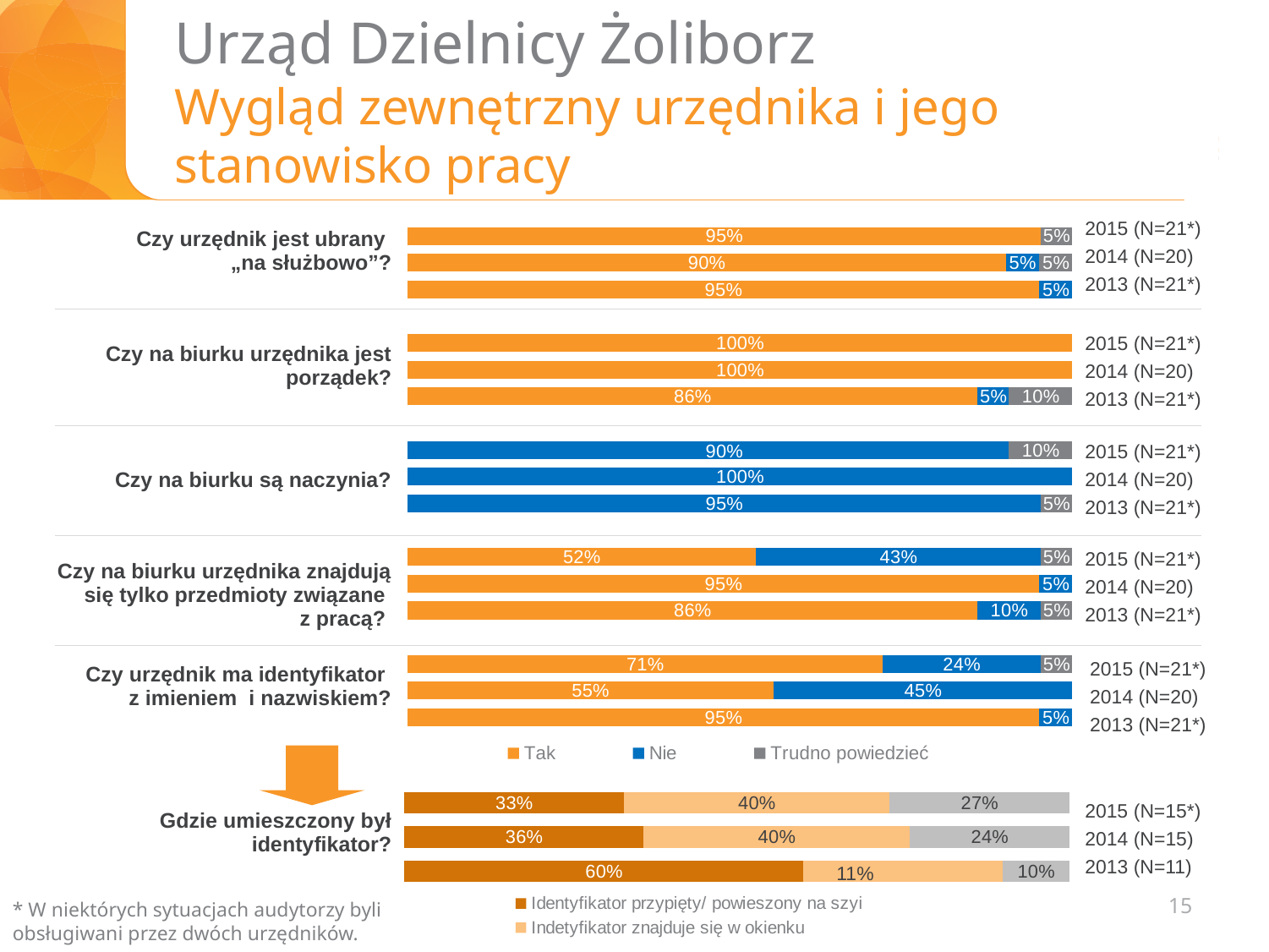
In the chart for "Czy urzędnik ma identyfikator z imieniem i nazwiskiem?", which year has the highest "Tak" value? 2013 (N=21*) In the chart for "Czy urzędnik ma identyfikator z imieniem i nazwiskiem?", what is the difference between the "Tak" values for 2015 (N=21*) and 2014 (N=20)? 16% How many series does the legend with "Tak", "Nie" and "Trudno powiedzieć" list? 3 In the chart for "Gdzie umieszczony był identyfikator?", which is larger for 2015 (N=15*): "Identyfikator przypięty/ powieszony na szyi" or "Indetyfikator znajduje się w okienku"? Indetyfikator znajduje się w okienku What type of chart is used for "Czy na biurku urzędnika jest porządek?"? Stacked bar chart How many years (bars) are shown in the chart for "Czy na biurku są naczynia?"? 3 In the chart for "Czy na biurku urzędnika jest porządek?", what is the "Tak" value for 2013 (N=21*)? 86% In the chart for "Gdzie umieszczony był identyfikator?", how does the "Identyfikator przypięty/ powieszony na szyi" value change from 2013 to 2015? It falls In the chart for "Czy na biurku są naczynia?", what is the "Trudno powiedzieć" value for 2015 (N=21*)? 10% In the chart for "Czy urzędnik jest ubrany „na służbowo”?", what is the "Tak" value for 2014 (N=20)? 90% In the chart for "Gdzie umieszczony był identyfikator?", what is the "Identyfikator przypięty/ powieszony na szyi" value for 2013 (N=11)? 60% In the chart for "Czy na biurku urzędnika znajdują się tylko przedmioty związane z pracą?", what is the "Nie" value for 2015 (N=21*)? 43%